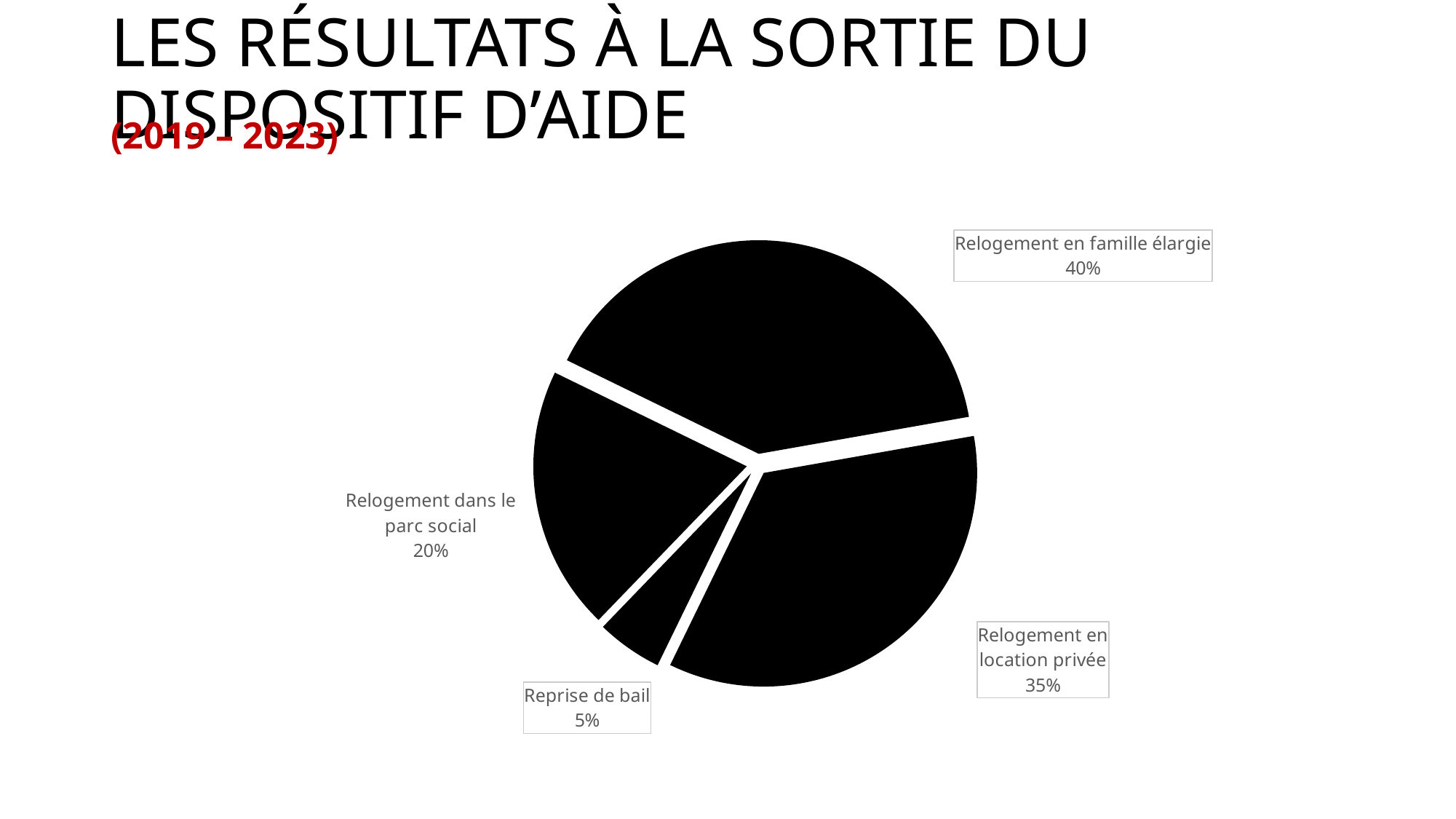
Which is larger: the share for 'Relogement dans le parc social' or the share for 'Relogement en location privée'? Relogement en location privée How many slices does the pie chart have? 4 What period is indicated in red below the slide title? (2019 – 2023) Which category has the largest share of the pie? Relogement en famille élargie What is the value shown for 'Relogement dans le parc social'? 20% Which category has the smallest share of the pie? Reprise de bail What is the value shown for 'Relogement en location privée'? 35% What is the value shown for 'Reprise de bail'? 5% What is the difference between the shares of 'Relogement en famille élargie' and 'Relogement en location privée'? 5% What is the difference between the shares of 'Relogement dans le parc social' and 'Reprise de bail'? 15% What share of the pie does 'Relogement en famille élargie' represent? 40% What kind of chart is shown on the slide? pie chart